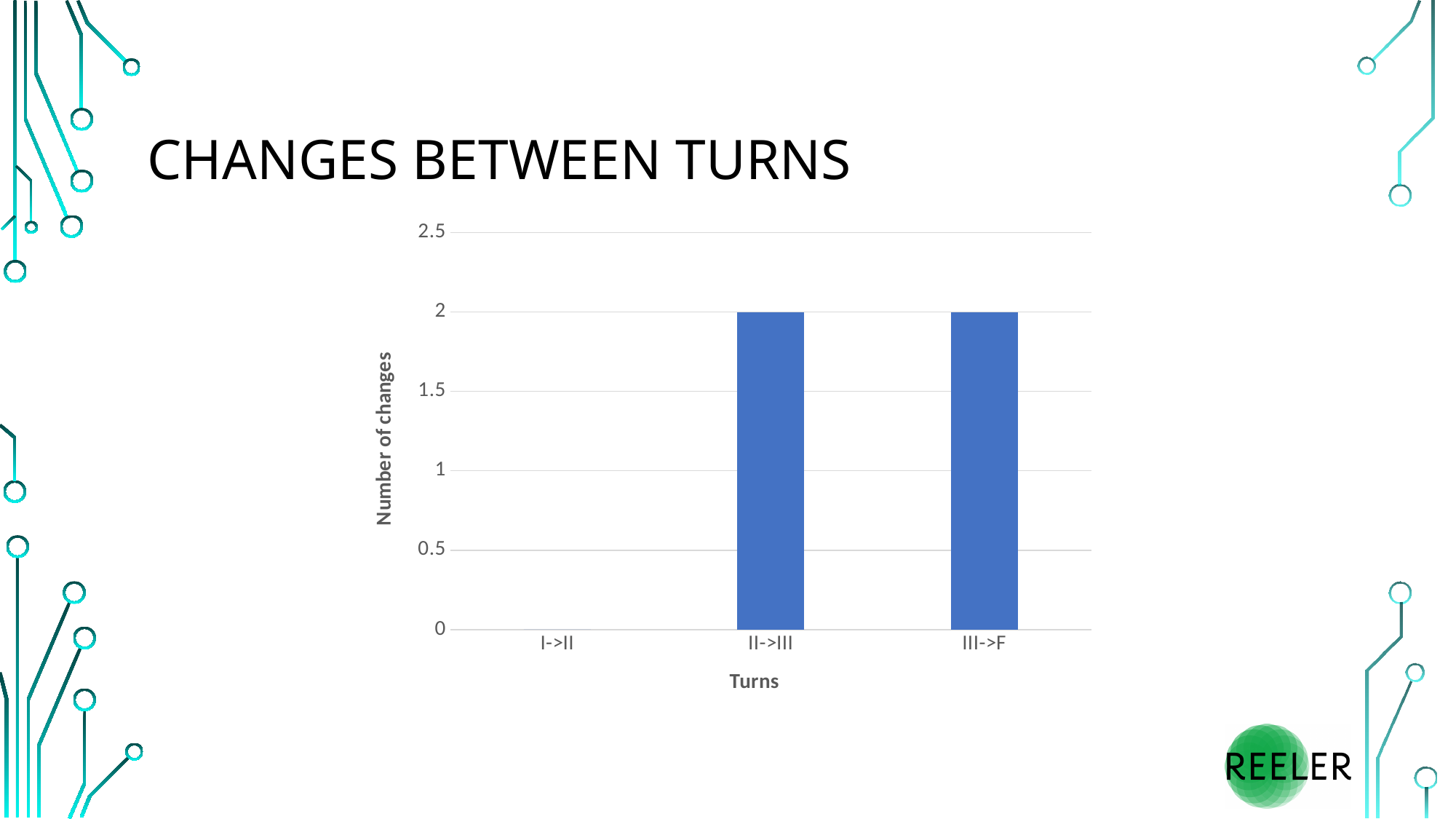
Which turn transition has the lowest number of changes? I->II Is the value for I->II greater or less than 1? less What is the number of changes for III->F? 2 What is the difference in number of changes between II->III and I->II? 2 Which has more changes, I->II or III->F? III->F What kind of chart is shown on the slide? bar chart How many turn transitions are shown on the x axis? 3 What is the number of changes for II->III? 2 Does the number of changes rise or fall from I->II to II->III? rise Is the value for II->III greater or less than 1.5? greater What is the number of changes for I->II? 0 What is the label of the vertical axis? Number of changes